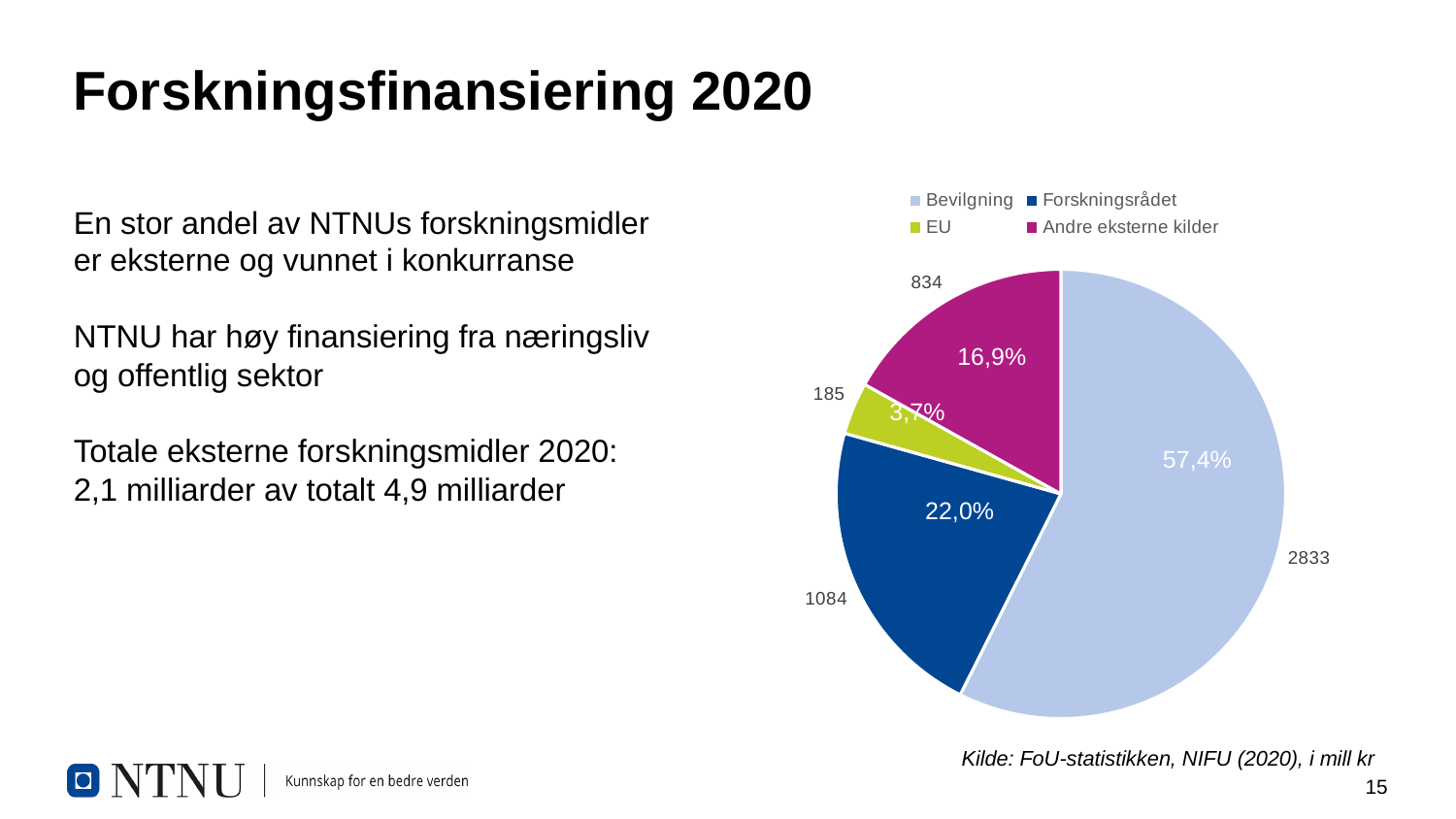
Which category has the largest slice in the pie chart? Bevilgning What is the difference between the values for Forskningsrådet and Andre eksterne kilder? 250 How many entries does the legend of the pie chart list? 4 What is the value shown for Bevilgning in the pie chart? 2833 What share of the pie does Bevilgning represent? 57,4% What share of the pie does Andre eksterne kilder represent? 16,9% What is the value shown for Andre eksterne kilder in the pie chart? 834 What is the value shown for Forskningsrådet in the pie chart? 1084 Which category has the smallest slice in the pie chart? EU What kind of chart is shown on the slide? pie chart What is the value shown for EU in the pie chart? 185 How many slices does the pie chart have? 4